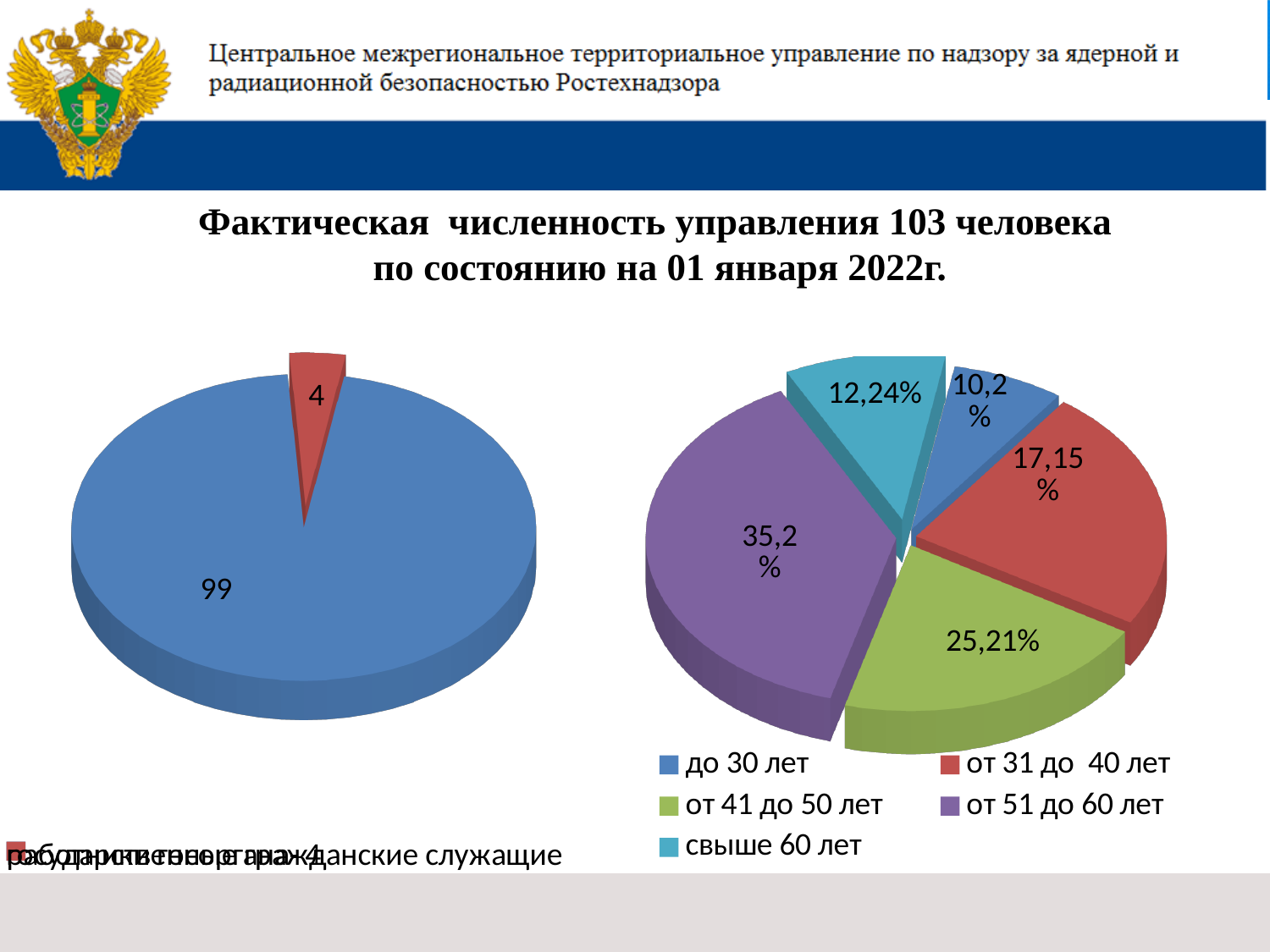
In the left-hand pie chart, what value is shown on the small red slice? 4 In the right-hand pie chart, what share is shown for the age group "от 31 до 40 лет"? 17,15% In the right-hand pie chart, what share is shown for the age group "до 30 лет"? 10,2% In the right-hand pie chart, what share is shown for the age group "от 41 до 50 лет"? 25,21% In the right-hand pie chart, which is larger: the share for "от 31 до 40 лет" or the share for "свыше 60 лет"? от 31 до 40 лет In the right-hand pie chart, which age group has the largest share? от 51 до 60 лет In the right-hand pie chart, what share is shown for the age group "свыше 60 лет"? 12,24% In the right-hand pie chart, which age group has the smallest share? до 30 лет In the left-hand pie chart, what value is shown on the large blue slice? 99 How many age groups does the legend of the right-hand pie chart list? 5 What kind of chart is the chart on the right of the slide? pie chart In the left-hand pie chart, what is the difference between the value of the blue slice and the value of the red slice? 95